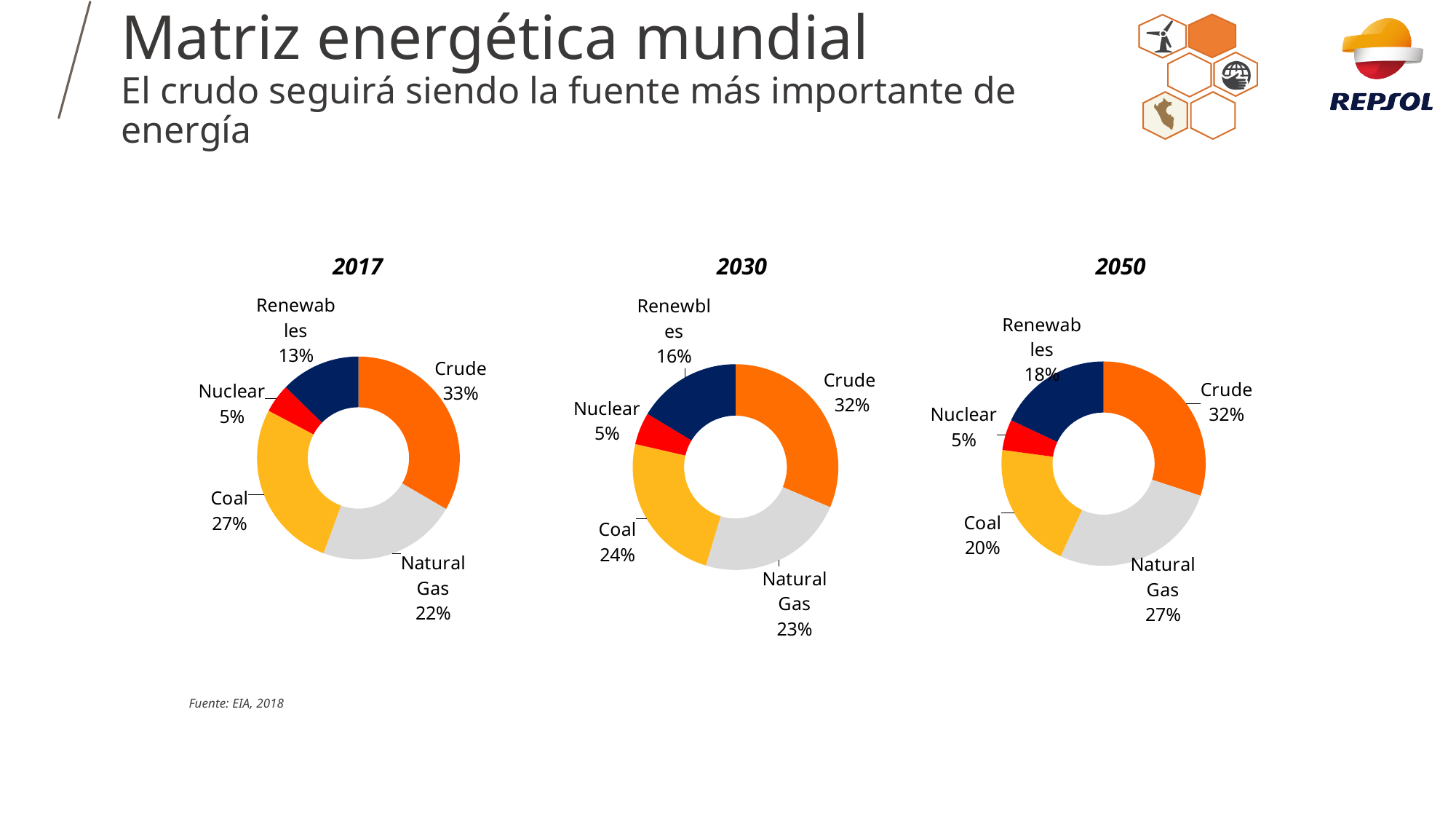
In the 2050 chart, what share do Renewables have? 18% In the 2017 chart, what share does Crude have? 33% In the 2050 chart, what share does Natural Gas have? 27% How many charts are on the slide? 3 In the 2050 chart, which is larger, Coal or Natural Gas? Natural Gas In the 2017 chart, which category has the largest share? Crude In the 2050 chart, what colour is the Nuclear slice? Red What kind of chart is the 2017 chart? Doughnut chart How many categories does the 2030 chart show? 5 In the 2030 chart, what share does Coal have? 24% In the 2017 chart, what is the difference between the Coal share and the Natural Gas share? 5% In the 2030 chart, which category has the smallest share? Nuclear